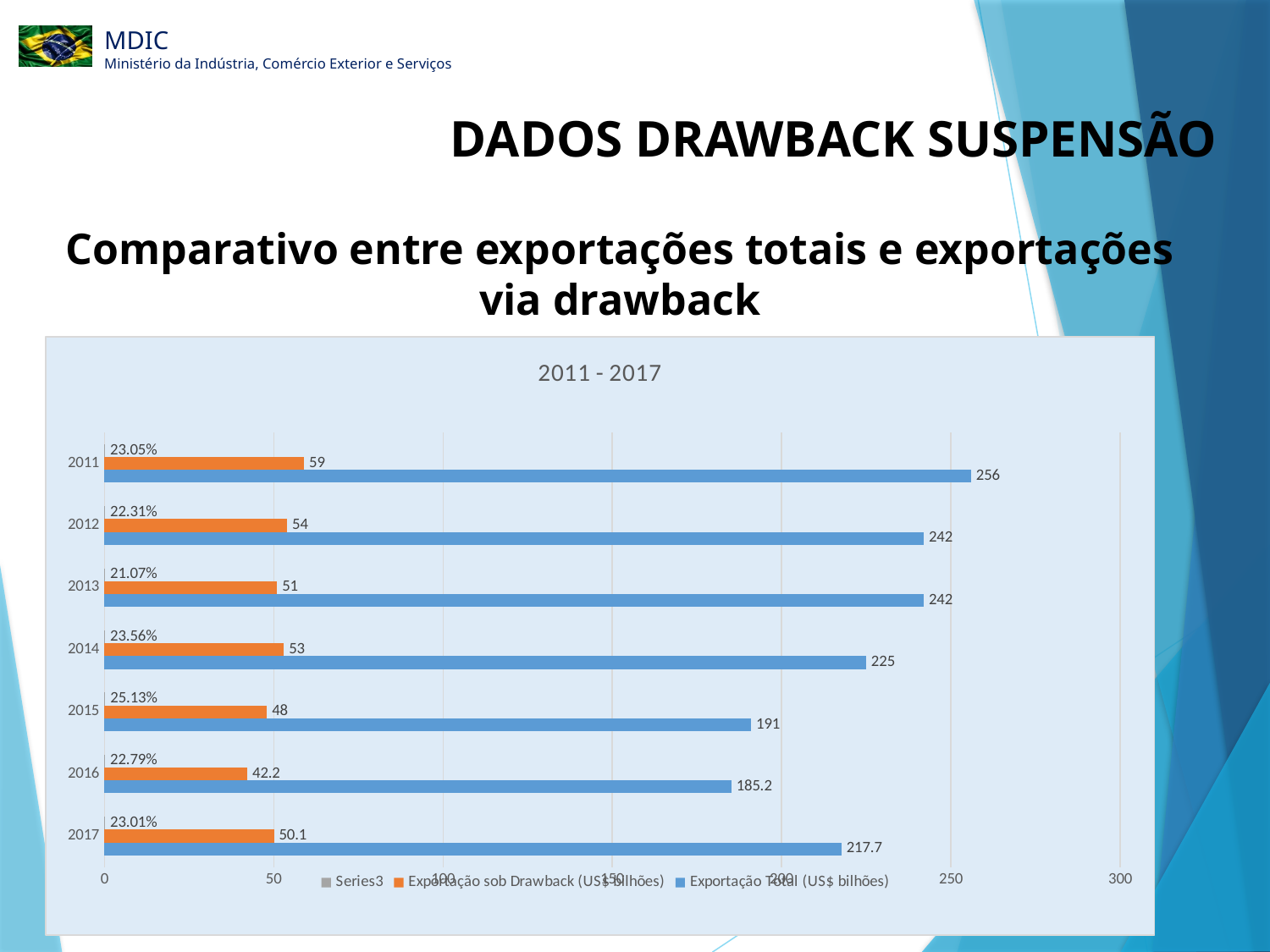
What percentage is shown for 2015? 25.13% Which year has the lowest Exportação sob Drawback (US$ bilhões)? 2016 Which year has the highest Exportação Total (US$ bilhões)? 2011 How many series does the legend list? 3 What kind of chart is shown on the slide? bar chart What is the value of Exportação sob Drawback (US$ bilhões) for 2016? 42.2 Is Exportação sob Drawback (US$ bilhões) larger in 2012 or in 2015? 2012 Is the Exportação Total (US$ bilhões) for 2016 greater or less than 200? less What is the difference between Exportação Total (US$ bilhões) in 2011 and in 2017? 38.3 What is the value of Exportação Total (US$ bilhões) for 2011? 256 What is the title of the chart? 2011 - 2017 How many years are shown on the chart? 7